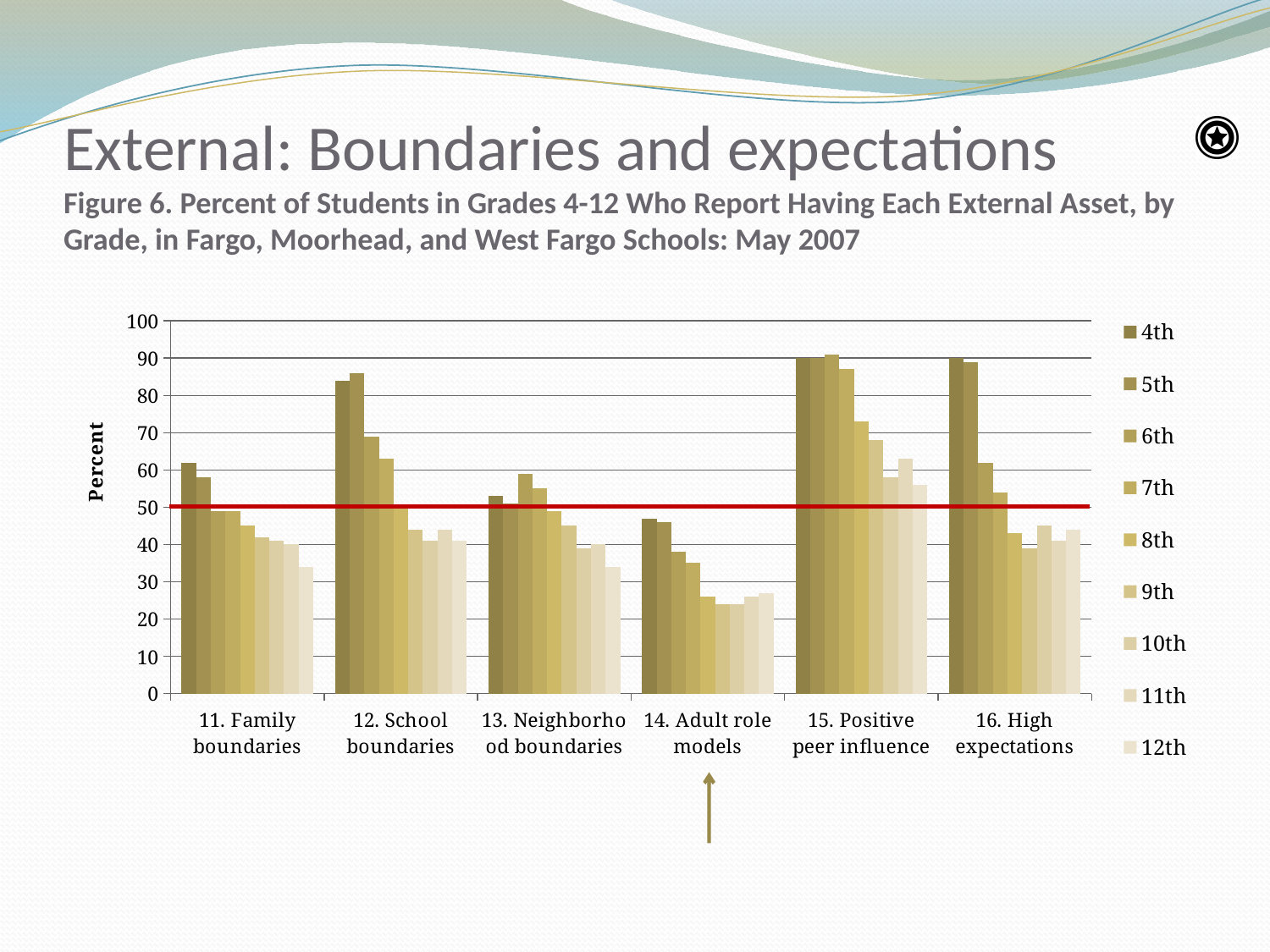
Is the 12th grade value for 14. Adult role models greater or less than 30? less What is the label on the y axis? Percent Is the 4th grade value for 15. Positive peer influence greater or less than 80? greater Within 11. Family boundaries, do the values rise or fall from 4th grade to 12th grade? fall Is the 12th grade value for 11. Family boundaries greater or less than 40? less What kind of chart is shown on the slide? bar chart At what value on the y axis is the red horizontal line drawn? 50 How many asset categories are shown along the x axis? 6 Which asset category has the lowest 12th grade value? 14. Adult role models Which is larger: the 4th grade value for 12. School boundaries or the 4th grade value for 11. Family boundaries? 12. School boundaries How many grade series does the legend list? 9